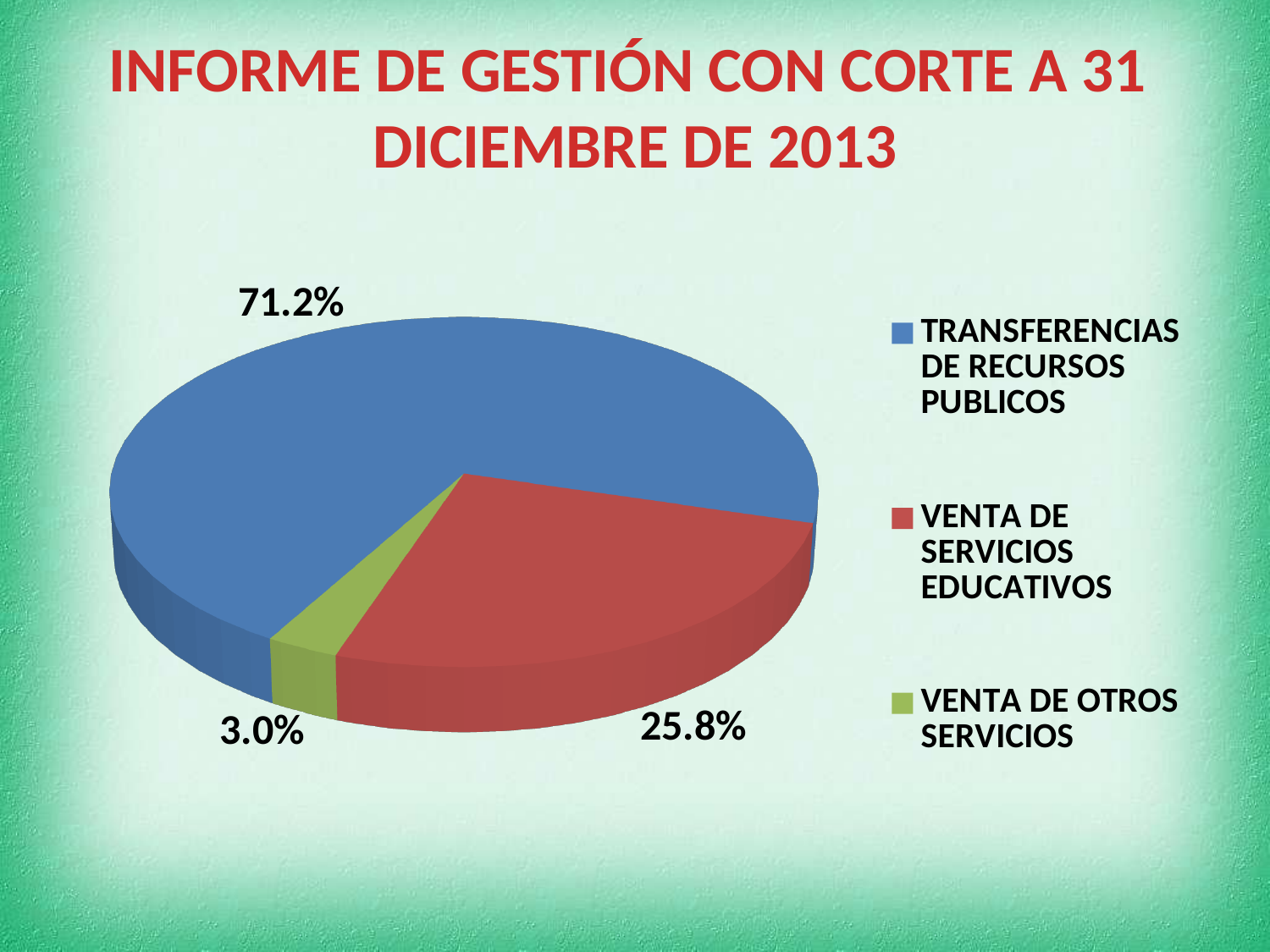
What colour is the slice for VENTA DE SERVICIOS EDUCATIVOS? Red How many entries does the legend list? 3 Which category has the largest slice of the pie? TRANSFERENCIAS DE RECURSOS PUBLICOS What is the difference in percentage points between TRANSFERENCIAS DE RECURSOS PUBLICOS and VENTA DE SERVICIOS EDUCATIVOS? 45.4 What percentage is shown for TRANSFERENCIAS DE RECURSOS PUBLICOS? 71.2% What kind of chart is shown on the slide? Pie chart Which is larger, the slice for VENTA DE SERVICIOS EDUCATIVOS or the slice for VENTA DE OTROS SERVICIOS? VENTA DE SERVICIOS EDUCATIVOS How many slices does the pie chart have? 3 What percentage is shown for VENTA DE OTROS SERVICIOS? 3.0% What is the title of the slide containing the chart? INFORME DE GESTIÓN CON CORTE A 31 DICIEMBRE DE 2013 What percentage is shown for VENTA DE SERVICIOS EDUCATIVOS? 25.8% Which category has the smallest slice of the pie? VENTA DE OTROS SERVICIOS